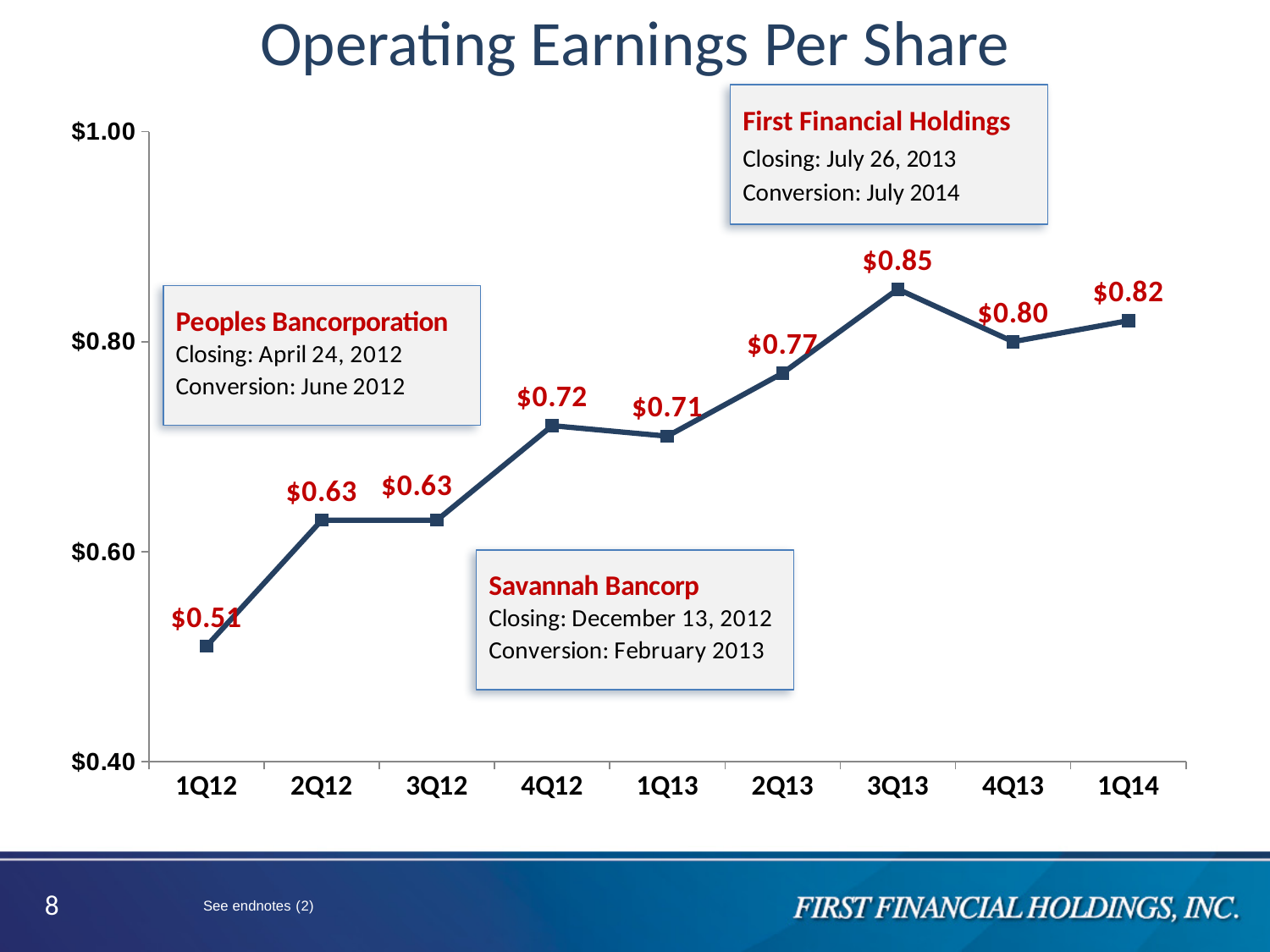
What kind of chart is shown on the slide? line chart What is the difference in operating earnings per share between 3Q13 and 1Q12? $0.34 Is the value for 2Q12 greater or less than $0.60? greater Which is larger, the operating earnings per share for 2Q13 or for 4Q13? 4Q13 What is the operating earnings per share for 1Q12? $0.51 What is the operating earnings per share for 1Q14? $0.82 What is the operating earnings per share for 3Q13? $0.85 Which quarter has the highest operating earnings per share? 3Q13 How many quarters are plotted on the chart? 9 Which quarter has the lowest operating earnings per share? 1Q12 What is the difference in operating earnings per share between 4Q12 and 1Q13? $0.01 What is the title of the chart? Operating Earnings Per Share